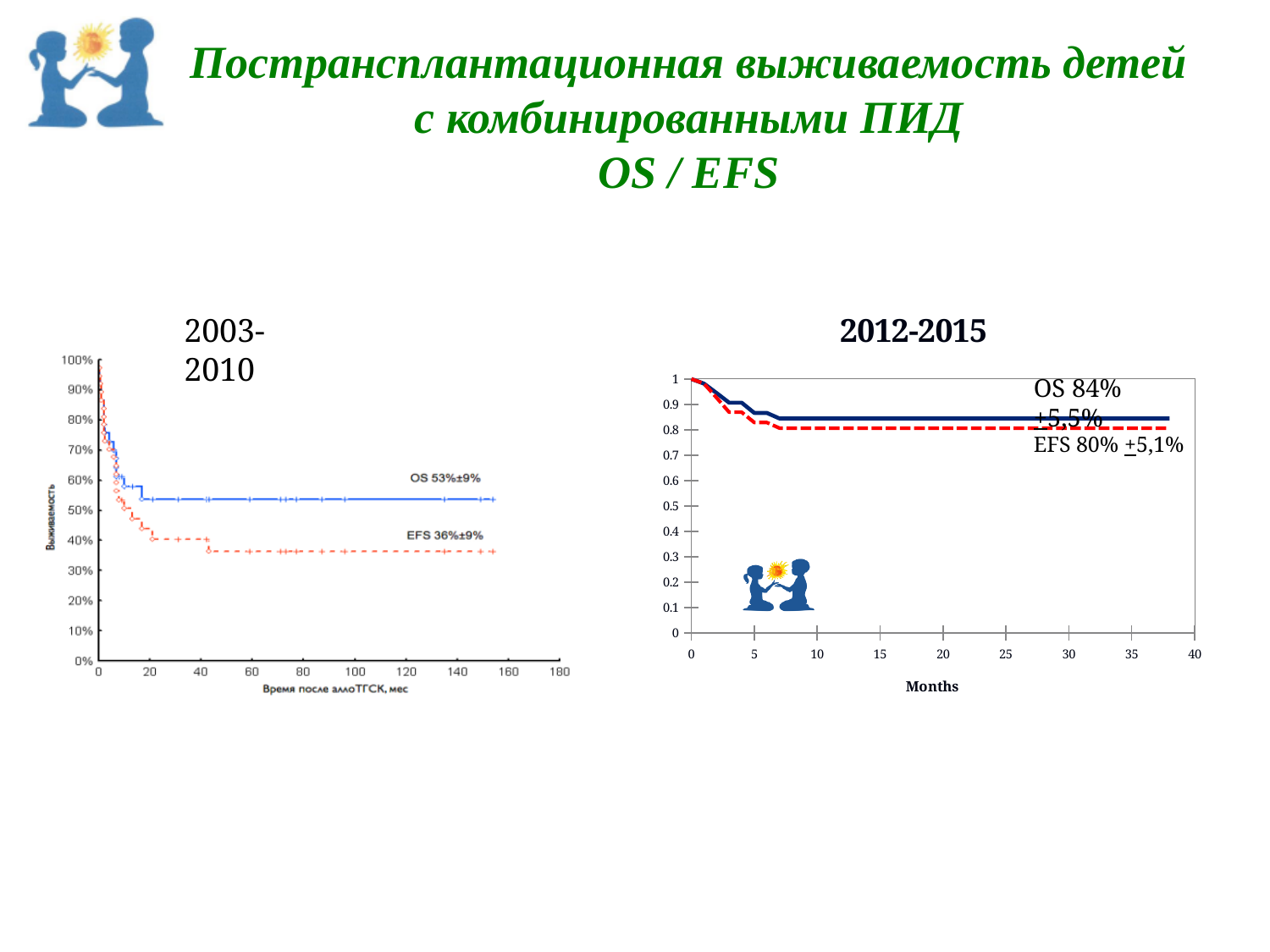
In the 2012-2015 chart, what is the difference between the labelled OS and EFS percentages? 4% In the 2012-2015 chart, which curve is higher, OS or EFS? OS What type of chart is the 2012-2015 chart? line chart How many survival curves are plotted in the 2012-2015 chart? 2 In the 2003-2010 chart, what is the difference between the labelled OS and EFS percentages? 17% In the 2012-2015 chart, what is the labelled EFS value? 80% ±5,1% In the 2003-2010 chart, what is the labelled EFS value? 36%±9% What is the x-axis label of the 2012-2015 chart? Months In the 2012-2015 chart, what is the labelled OS value? 84% ±5,5% In the 2003-2010 chart, do the survival curves rise or fall as time after transplantation increases? fall In the 2003-2010 chart, what is the labelled OS value? 53%±9% In the 2003-2010 chart, is the EFS curve at 100 months greater or less than 50%? less